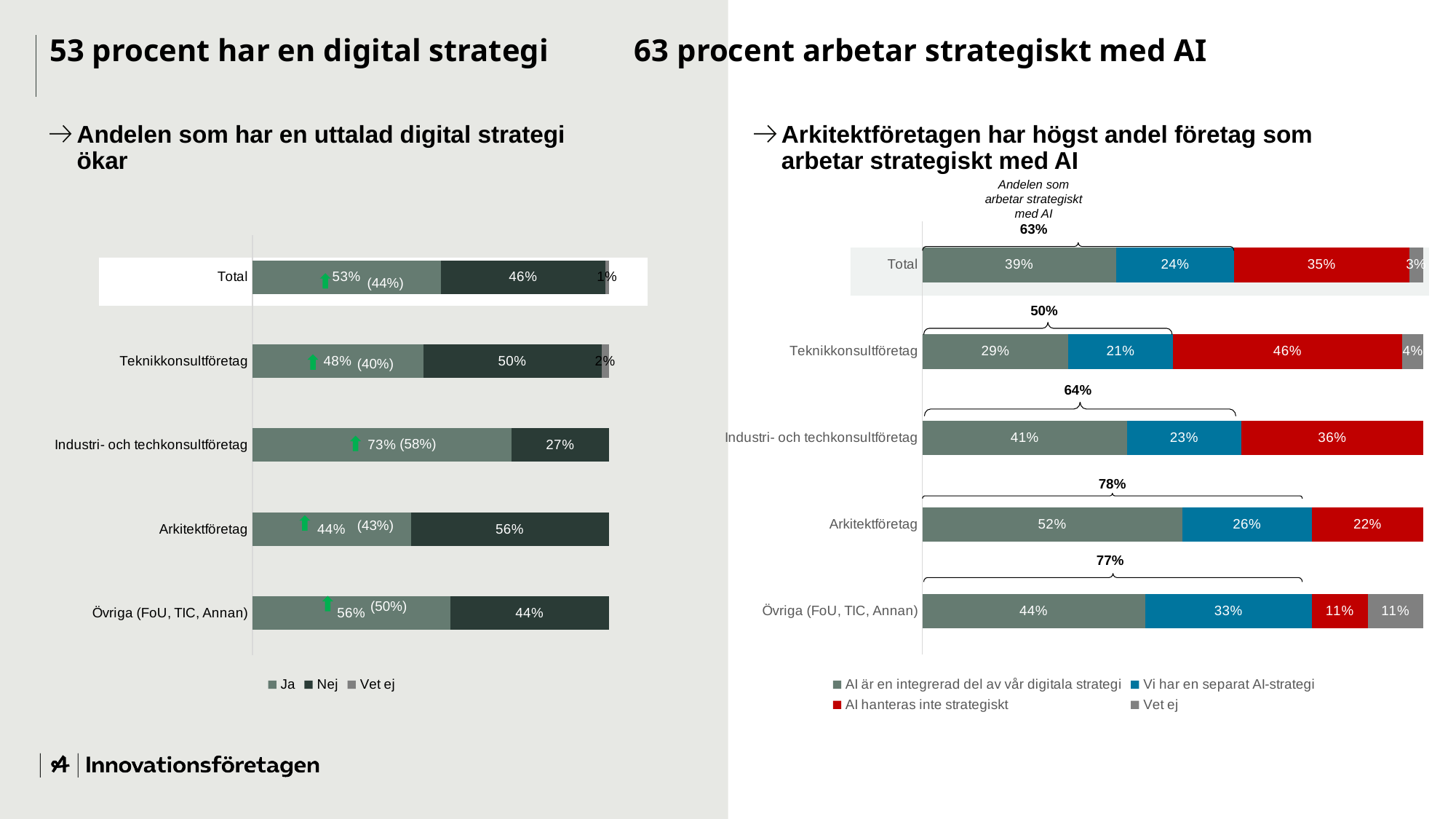
What type of chart is the right chart (63 procent arbetar strategiskt med AI)? Stacked bar chart In the left chart (53 procent har en digital strategi), what is the 'Ja' value for Industri- och techkonsultföretag? 73% In the right chart (63 procent arbetar strategiskt med AI), what is the 'AI hanteras inte strategiskt' value for Teknikkonsultföretag? 46% In the left chart (53 procent har en digital strategi), which category has the highest 'Ja' share? Industri- och techkonsultföretag In the right chart (63 procent arbetar strategiskt med AI), which category has the highest share that works strategically with AI (the bracketed total)? Arkitektföretag In the left chart (53 procent har en digital strategi), what is the difference between the 'Ja' and 'Nej' values for Teknikkonsultföretag? 2% In the right chart (63 procent arbetar strategiskt med AI), how many series does the legend list? 4 In the right chart (63 procent arbetar strategiskt med AI), is the 'AI är en integrerad del av vår digitala strategi' value larger for Arkitektföretag or for Teknikkonsultföretag? Arkitektföretag In the left chart (53 procent har en digital strategi), how many series does the legend list? 3 In the right chart (63 procent arbetar strategiskt med AI), what is the 'Vi har en separat AI-strategi' value for Övriga (FoU, TIC, Annan)? 33% In the left chart (53 procent har en digital strategi), which category has the lowest 'Ja' share? Arkitektföretag In the left chart (53 procent har en digital strategi), what is the 'Nej' value for Arkitektföretag? 56%